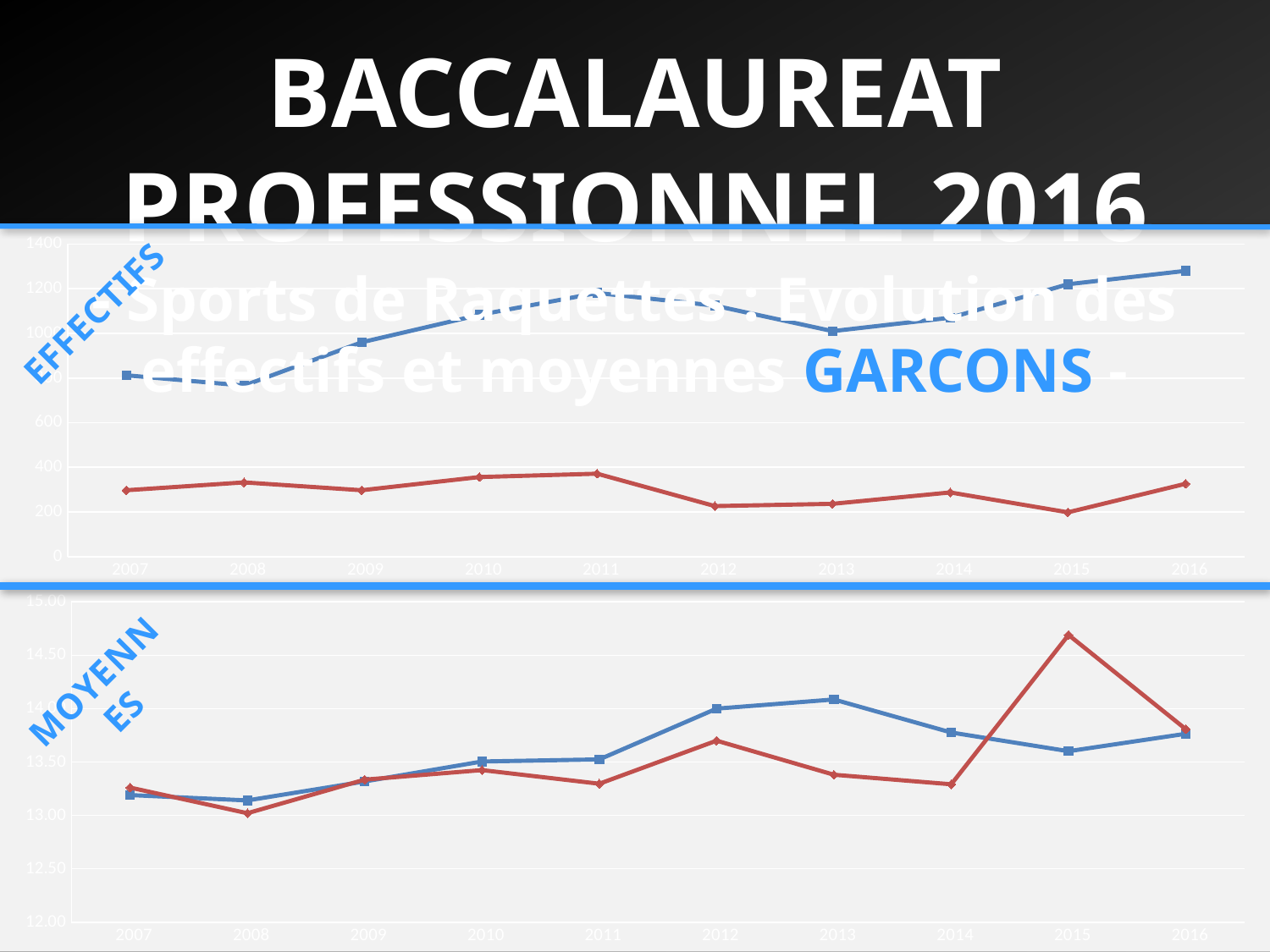
In the bottom chart (MOYENNES), is the value of the blue line for 2007 greater or less than 13.50? less In the top chart (EFFECTIFS), in which year does the red line reach its lowest value? 2015 What kind of chart is the top chart (EFFECTIFS)? line chart In the top chart (EFFECTIFS), in which year does the blue line reach its highest value? 2016 In the top chart (EFFECTIFS), is the value of the blue line for 2009 greater or less than 1000? less In the bottom chart (MOYENNES), in which year does the red line reach its highest value? 2015 What kind of chart is the bottom chart (MOYENNES)? line chart In the top chart (EFFECTIFS), which line is higher across all years, the blue line or the red line? the blue line In the bottom chart (MOYENNES), is the value of the red line for 2015 greater or less than 14.50? greater How many years are shown on the x axis of the top chart (EFFECTIFS)? 10